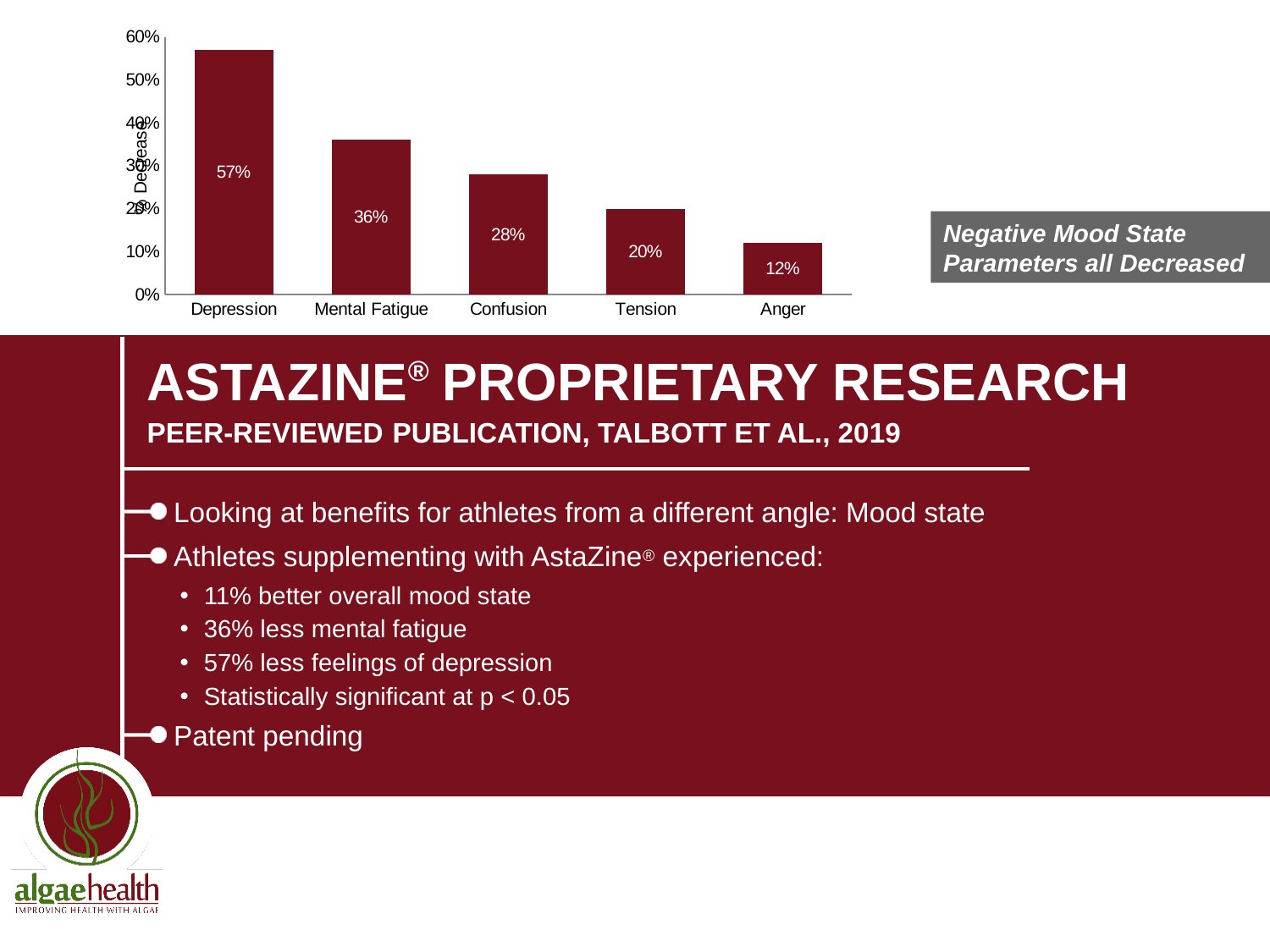
How many categories are shown on the x axis? 5 What is the difference between the values for Depression and Mental Fatigue? 21% Which category has the lowest value? Anger What kind of chart is shown on the slide? Bar chart Which is larger, the value for Confusion or the value for Tension? Confusion What is the value for Confusion? 28% Which category has the highest value? Depression What is the value for Tension? 20% What is the value for Anger? 12% Do the values rise or fall from left to right along the x axis? Fall What is the value for Mental Fatigue? 36% What is the value for Depression? 57%